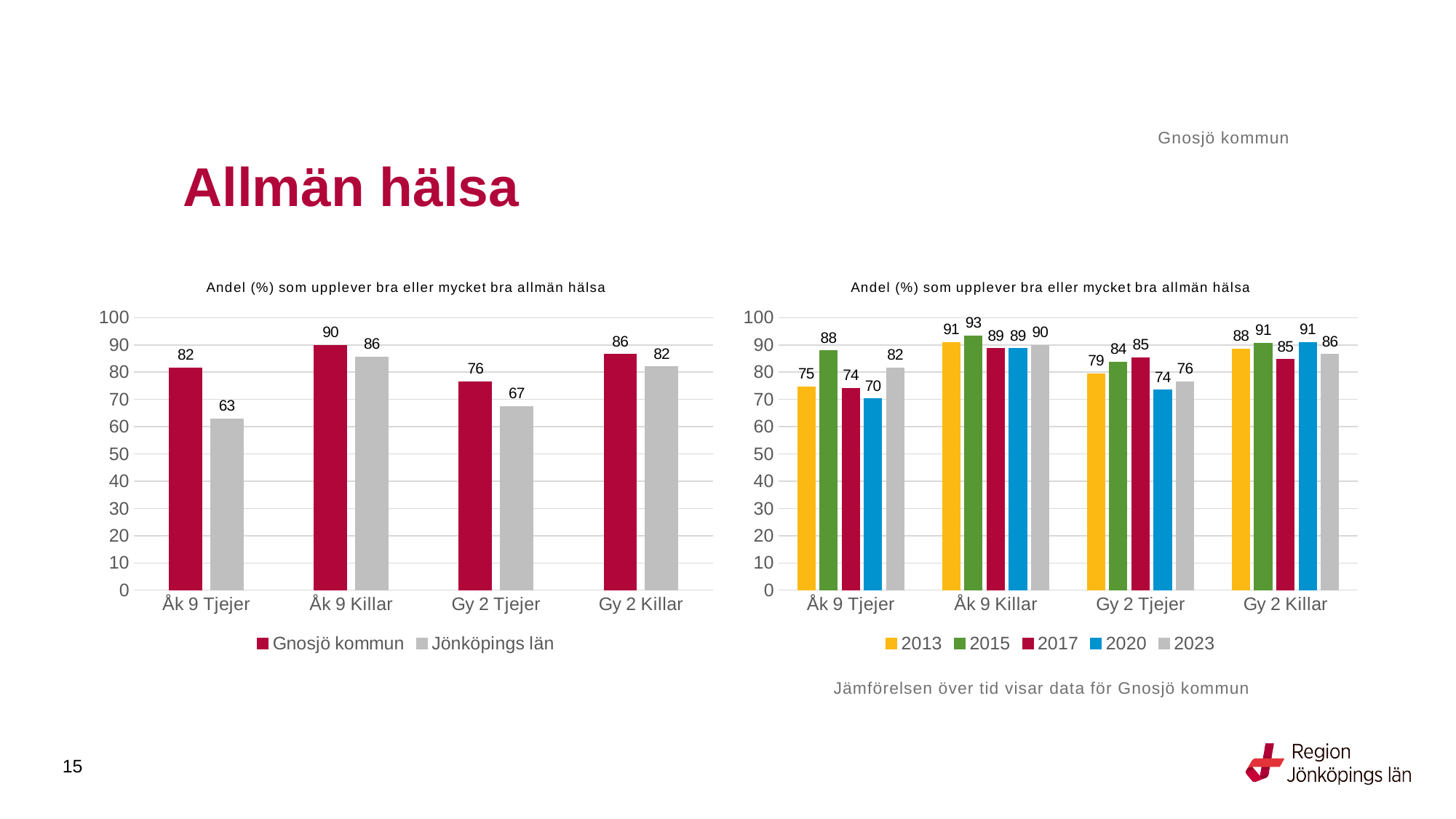
In the right chart, what is the value for 2015 for Åk 9 Killar? 93 In the left chart, what is the value for Jönköpings län for Gy 2 Tjejer? 67 In the left chart, what is the value for Gnosjö kommun for Åk 9 Tjejer? 82 In the left chart, which is larger for Åk 9 Killar: Gnosjö kommun or Jönköpings län? Gnosjö kommun How many series does the legend of the left chart list? 2 In the right chart, what is the value for 2020 for Gy 2 Tjejer? 74 In the left chart, which category has the lowest value for Jönköpings län? Åk 9 Tjejer In the left chart, which category has the highest value for Gnosjö kommun? Åk 9 Killar In the right chart, which year has the lowest value for Åk 9 Tjejer? 2020 What kind of chart is the right chart? Bar chart How many series does the legend of the right chart list? 5 In the left chart, what is the difference between Gnosjö kommun and Jönköpings län for Åk 9 Tjejer? 19